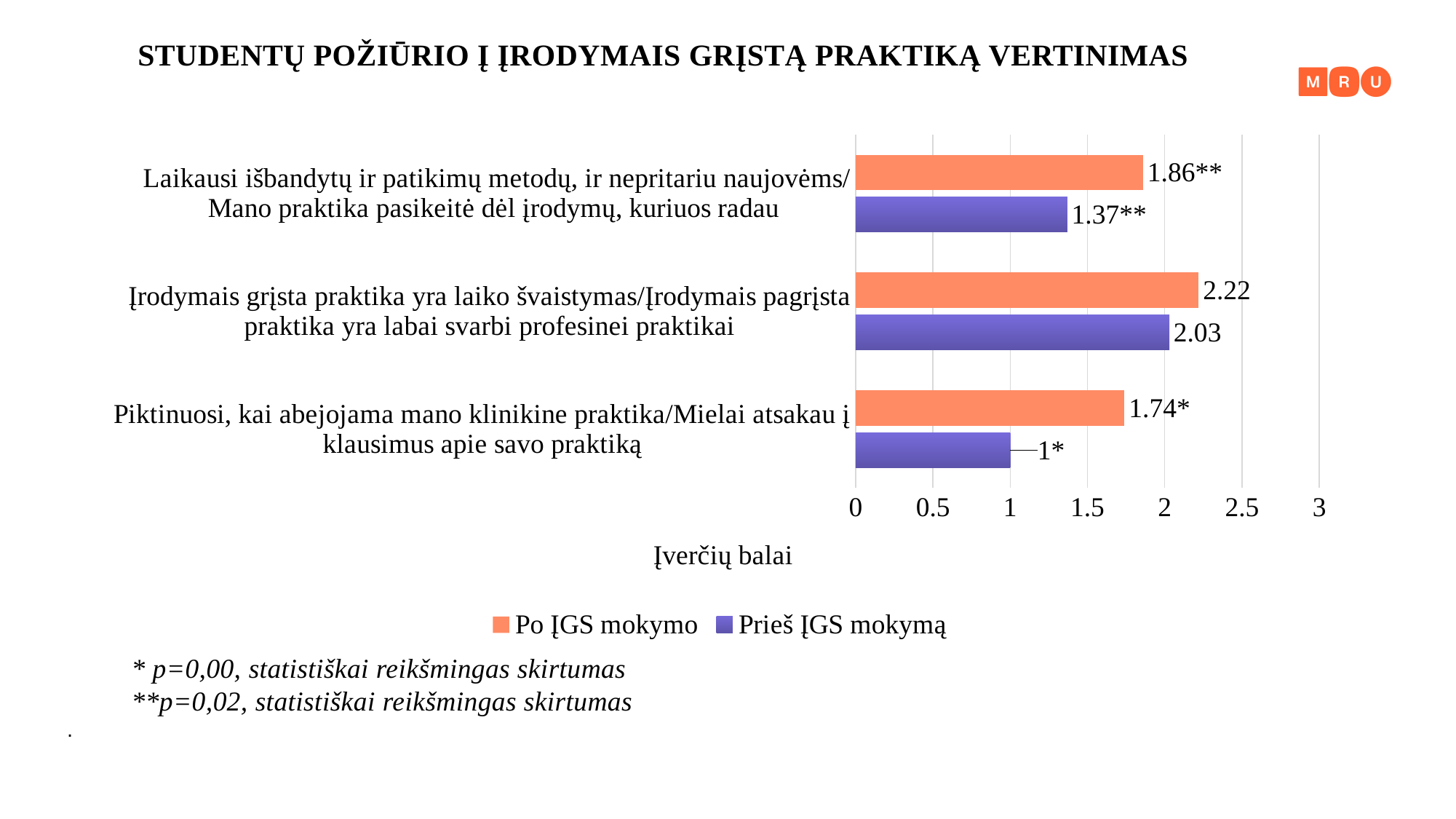
How many series does the legend list? 2 What is the value for 'Po ĮGS mokymo' in the category 'Laikausi išbandytų ir patikimų metodų, ir nepritariu naujovėms/Mano praktika pasikeitė dėl įrodymų, kuriuos radau'? 1.86** What type of chart is shown on the slide? bar chart What is the x-axis title of the chart? Įverčių balai In the category 'Laikausi išbandytų ir patikimų metodų, ir nepritariu naujovėms/Mano praktika pasikeitė dėl įrodymų, kuriuos radau', which series has the larger value? Po ĮGS mokymo What is the value for 'Prieš ĮGS mokymą' in the category 'Įrodymais grįsta praktika yra laiko švaistymas/Įrodymais pagrįsta praktika yra labai svarbi profesinei praktikai'? 2.03 How many categories are shown on the chart? 3 What is the difference between the 'Po ĮGS mokymo' and 'Prieš ĮGS mokymą' values in the category 'Piktinuosi, kai abejojama mano klinikine praktika/Mielai atsakau į klausimus apie savo praktiką'? 0.74 What is the value for 'Prieš ĮGS mokymą' in the category 'Piktinuosi, kai abejojama mano klinikine praktika/Mielai atsakau į klausimus apie savo praktiką'? 1* Which category has the highest value for 'Po ĮGS mokymo'? Įrodymais grįsta praktika yra laiko švaistymas/Įrodymais pagrįsta praktika yra labai svarbi profesinei praktikai What is the value for 'Po ĮGS mokymo' in the category 'Įrodymais grįsta praktika yra laiko švaistymas/Įrodymais pagrįsta praktika yra labai svarbi profesinei praktikai'? 2.22 Which category has the lowest value for 'Prieš ĮGS mokymą'? Piktinuosi, kai abejojama mano klinikine praktika/Mielai atsakau į klausimus apie savo praktiką